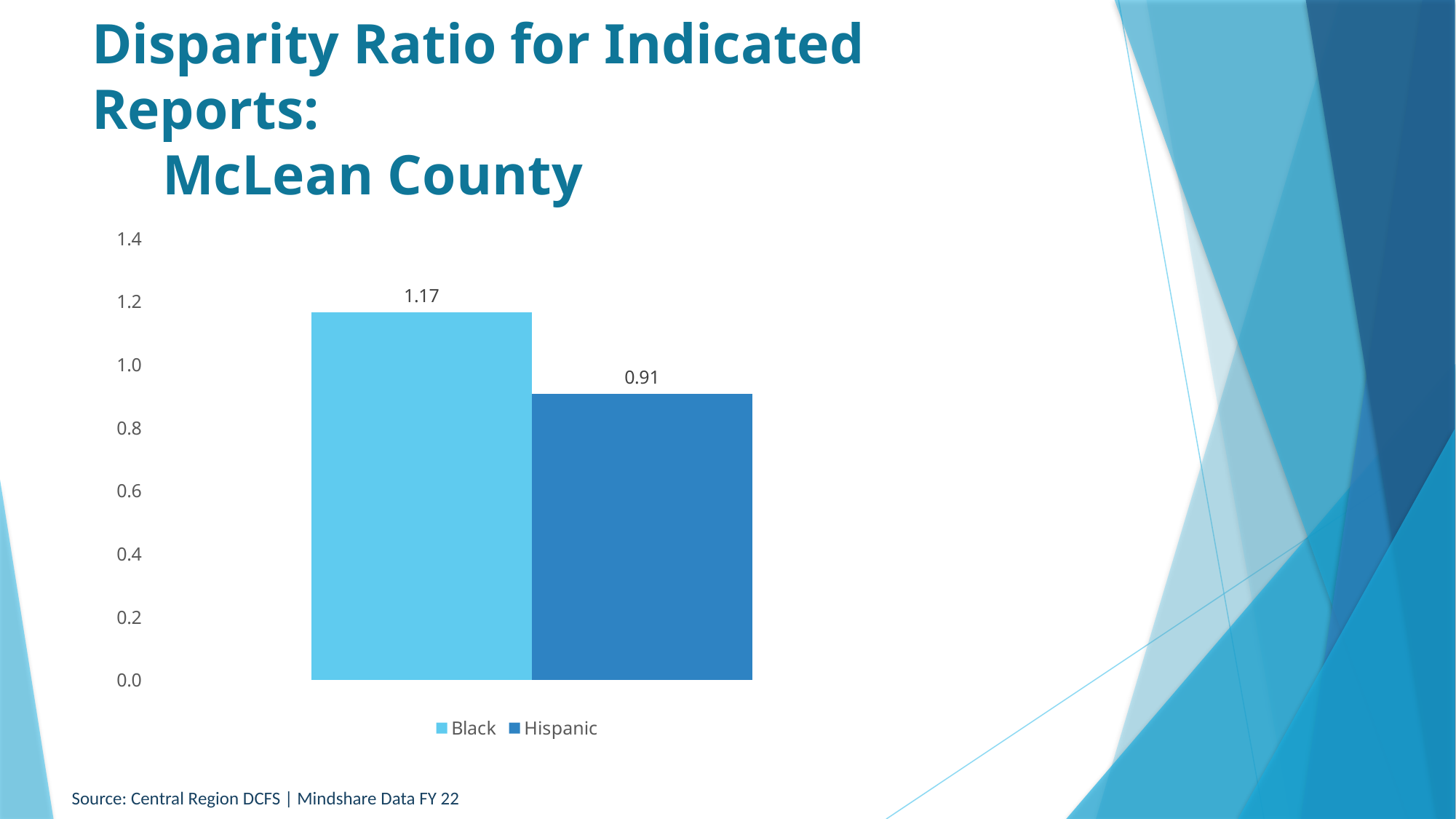
How many series does the legend list? 2 Which series has the higher disparity ratio? Black What is the maximum value shown on the vertical axis? 1.4 Which series has the lower disparity ratio? Hispanic What kind of chart is shown on the slide? bar chart What is the difference between the Black and Hispanic disparity ratios? 0.26 Is the value for Hispanic greater or less than 1.0? less Is the value for Black greater or less than 1.0? greater What is the disparity ratio for Black? 1.17 Is the disparity ratio for Black larger or smaller than the ratio for Hispanic? larger How many bars are plotted in the chart? 2 What is the disparity ratio for Hispanic? 0.91